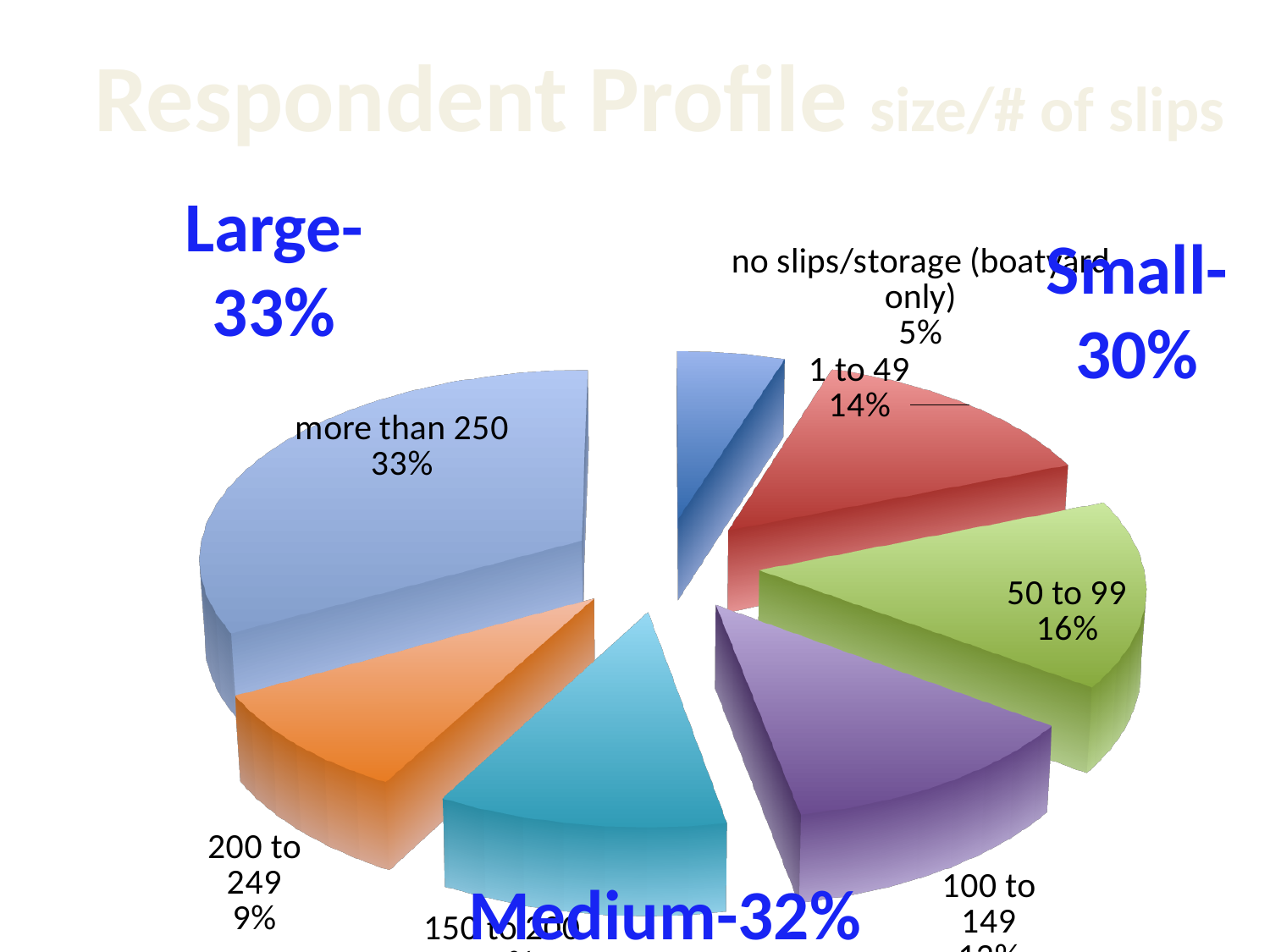
What percentage of respondents have 1 to 49 slips? 14% According to the annotation on the slide, what share of respondents are classified as Small? 30% Which category has the smallest share of the pie? no slips/storage (boatyard only) How many slices does the pie chart have? 7 How many percentage points larger is the 'more than 250' slice than the '200 to 249' slice? 24 percentage points What kind of chart is shown on the slide? pie chart What percentage of respondents have no slips/storage (boatyard only)? 5% What percentage of respondents have 200 to 249 slips? 9% Which category has the largest share of the pie? more than 250 Which slice is larger: '1 to 49' or '200 to 249'? 1 to 49 What percentage of respondents have 50 to 99 slips? 16% What percentage of respondents have more than 250 slips? 33%